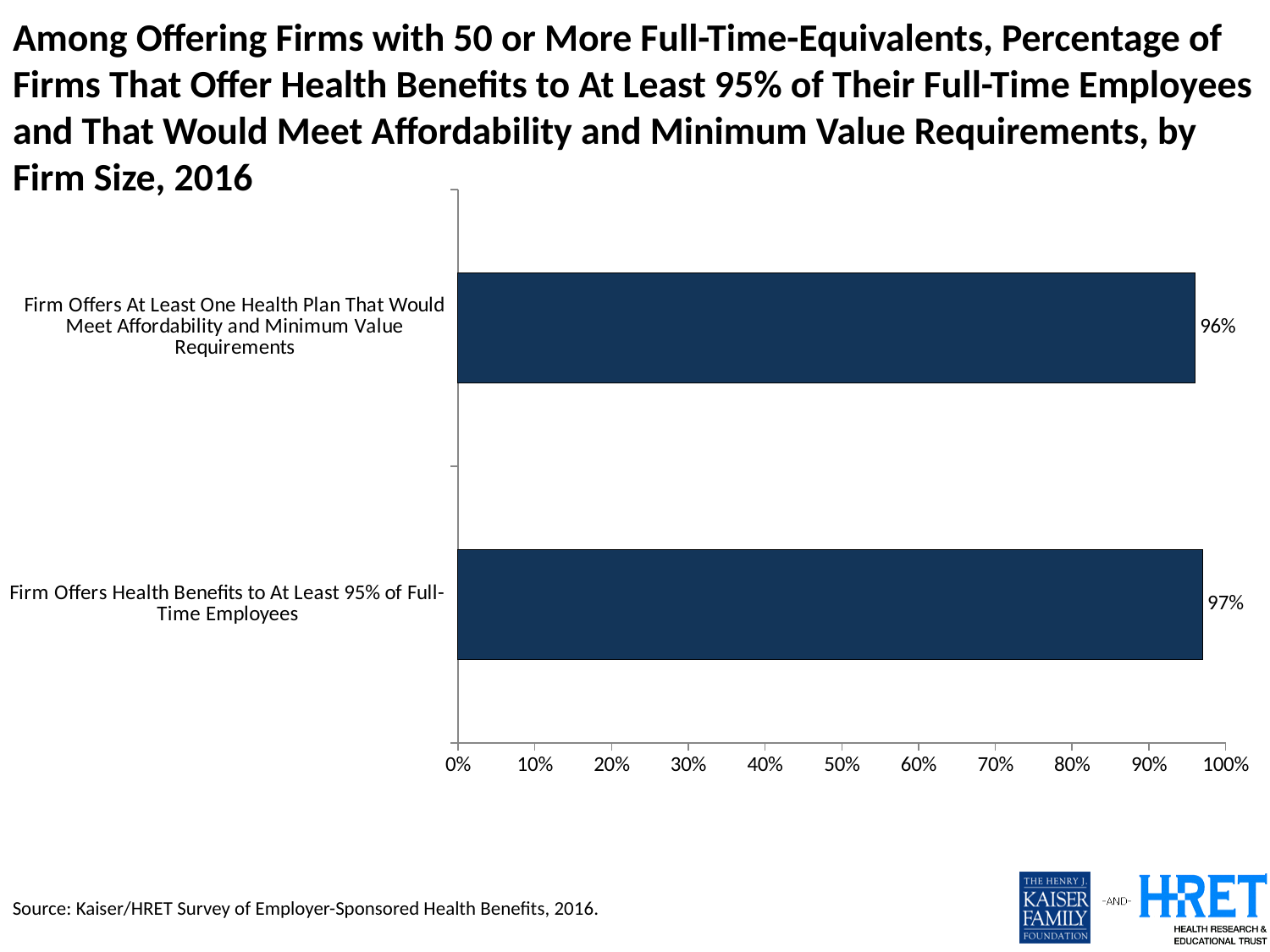
Which category has the lower value? Firm Offers At Least One Health Plan That Would Meet Affordability and Minimum Value Requirements What percentage of firms offer health benefits to at least 95% of full-time employees? 97% What kind of chart is shown on the slide? Bar chart What is the maximum value shown on the x axis? 100% What is the difference between the two bar values? 1 percentage point How many categories are shown in the chart? 2 Which category has the higher value? Firm Offers Health Benefits to At Least 95% of Full-Time Employees Is the value for firms offering a plan meeting affordability and minimum value requirements greater or less than 90%? greater What percentage of firms offer at least one health plan that would meet affordability and minimum value requirements? 96% What is the source cited for the chart? Kaiser/HRET Survey of Employer-Sponsored Health Benefits, 2016